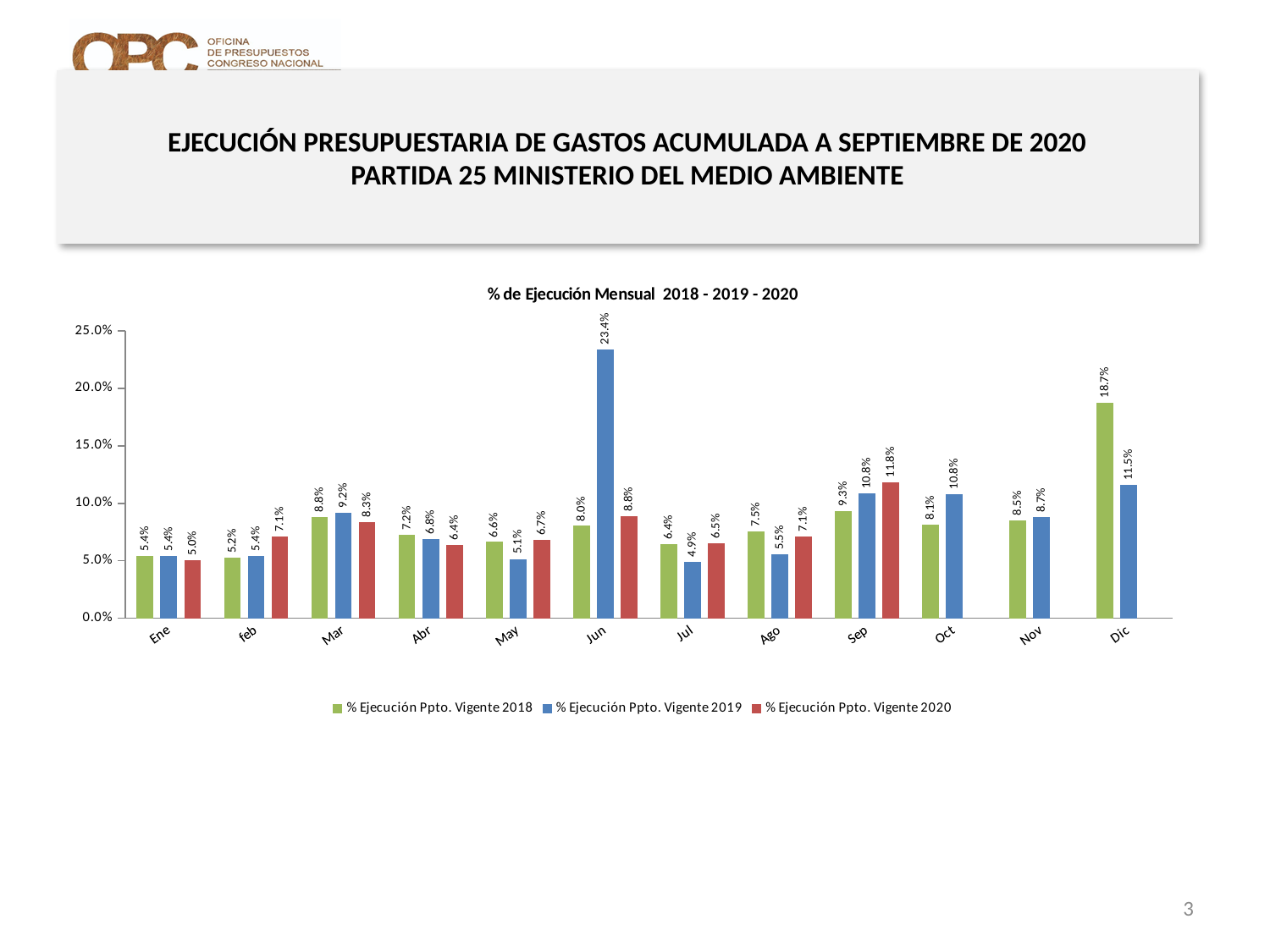
What is the title of the chart? % de Ejecución Mensual 2018 - 2019 - 2020 What is the value for % Ejecución Ppto. Vigente 2019 in Jun? 23.4% What is the difference between the 2019 and 2018 values in Jun? 15.4% What is the value for % Ejecución Ppto. Vigente 2018 in Dic? 18.7% How many series does the legend list? 3 What kind of chart is shown on the slide? Bar chart Which month has the lowest value for % Ejecución Ppto. Vigente 2019? Jul Which is larger in Dic: the 2018 value or the 2019 value? 2018 Is the value for % Ejecución Ppto. Vigente 2018 in Dic greater or less than 15.0%? greater How many months are shown on the x axis? 12 Which month has the highest value for % Ejecución Ppto. Vigente 2019? Jun What is the value for % Ejecución Ppto. Vigente 2020 in Sep? 11.8%